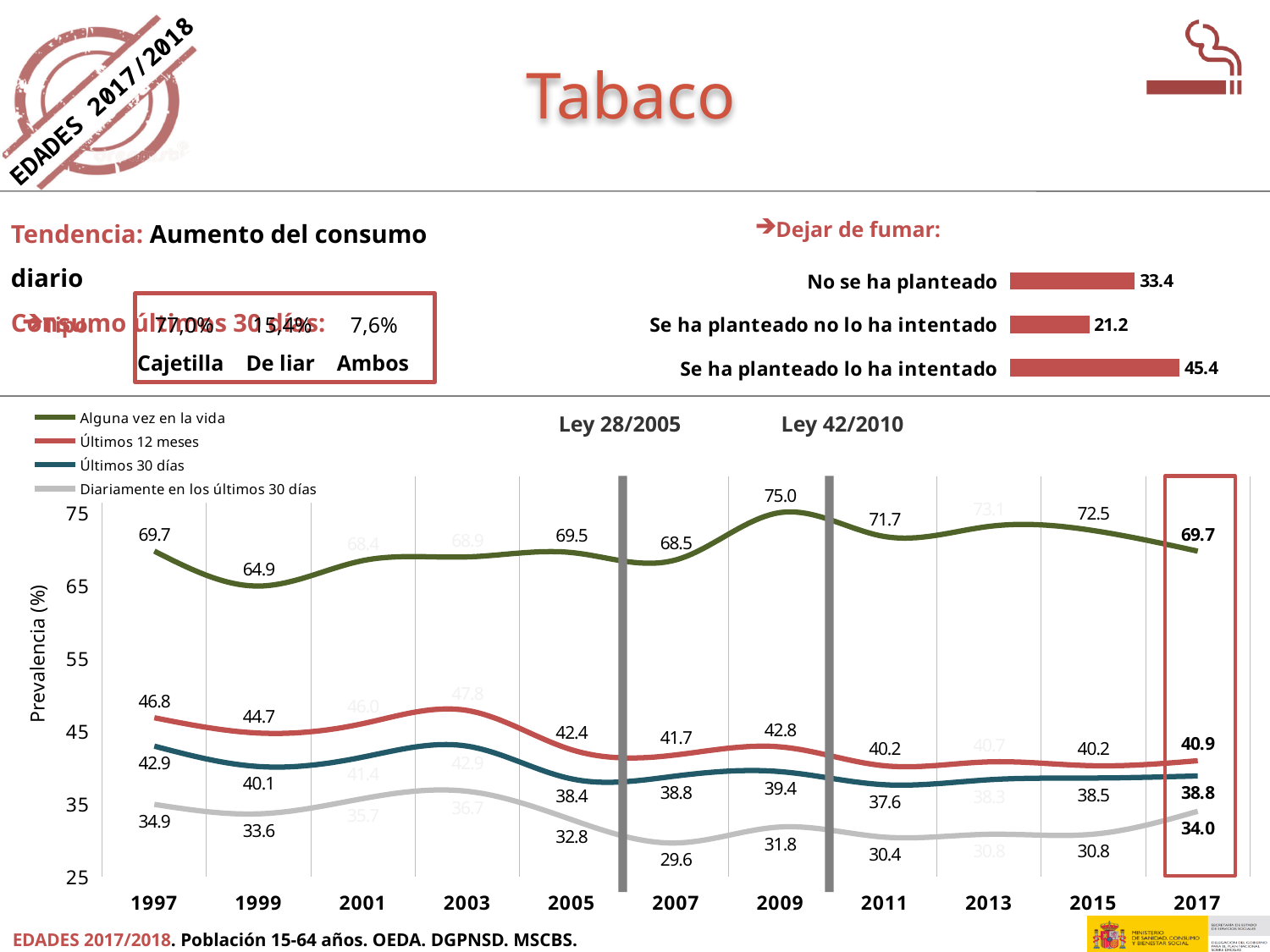
What kind of chart is the 'Dejar de fumar' chart? Bar chart In the line chart at the bottom, in which year does 'Alguna vez en la vida' reach its highest value? 2009 In the line chart at the bottom, what is the value of 'Diariamente en los últimos 30 días' in 2007? 29.6 In the line chart at the bottom, is the value of 'Últimos 12 meses' higher in 1997 or in 2017? 1997 In the line chart at the bottom, what is the difference between the 'Últimos 30 días' values in 1997 and 2017? 4.1 In the line chart at the bottom, in which year is 'Diariamente en los últimos 30 días' lowest? 2007 In the 'Dejar de fumar' bar chart, what is the value for 'Se ha planteado lo ha intentado'? 45.4 In the 'Dejar de fumar' bar chart, what is the difference between 'Se ha planteado lo ha intentado' and 'No se ha planteado'? 12.0 In the 'Dejar de fumar' bar chart, which category has the lowest value? Se ha planteado no lo ha intentado In the line chart at the bottom, what is the value of 'Alguna vez en la vida' in 2009? 75.0 In the line chart at the bottom, how many years are shown on the x axis? 11 In the line chart at the bottom, how many series does the legend list? 4